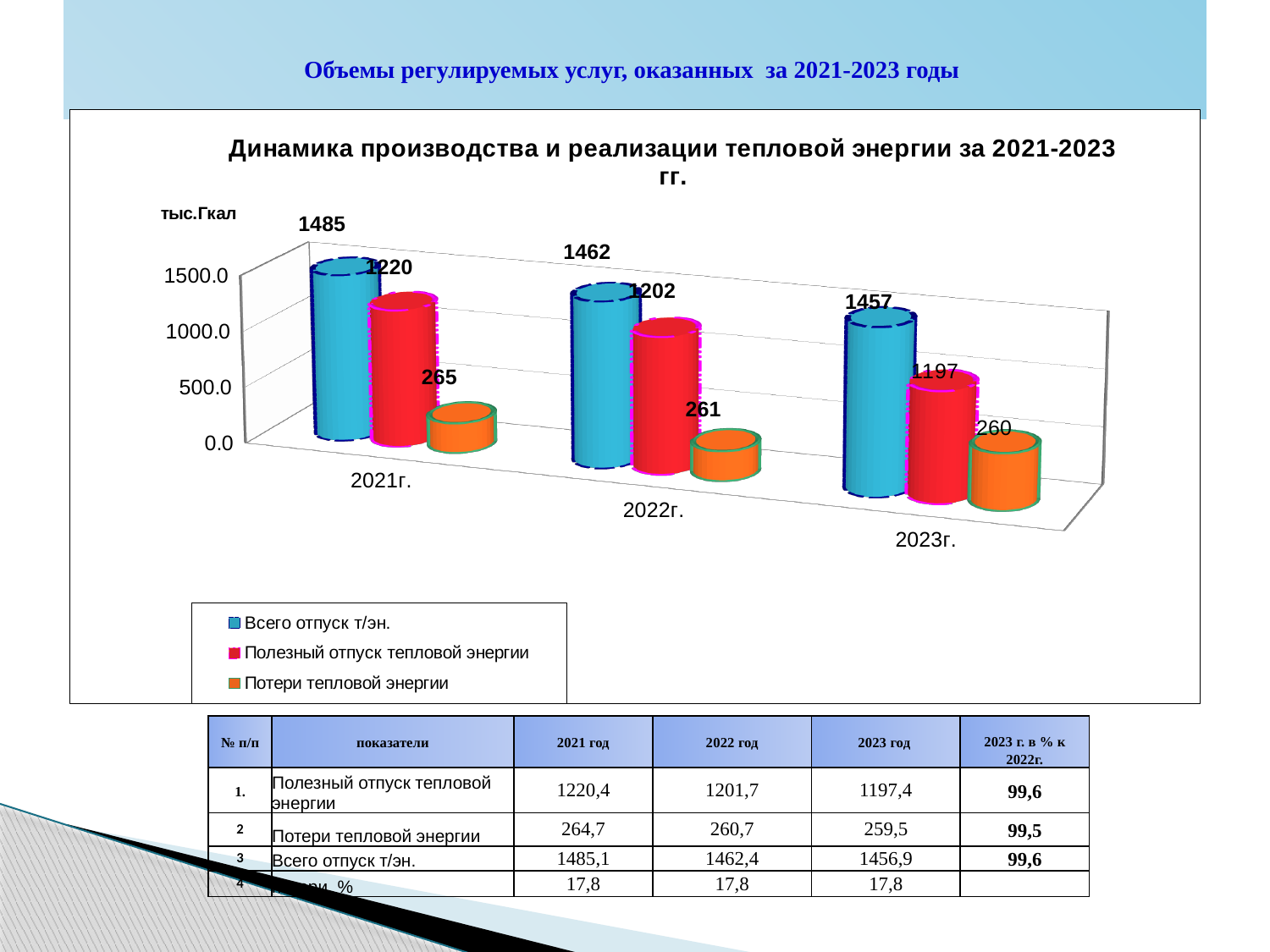
What is the value for "Всего отпуск т/эн." in 2021г.? 1485 How many years are shown on the x axis of the chart? 3 How many series does the chart legend list? 3 Does "Всего отпуск т/эн." rise or fall from 2021г. to 2023г.? fall Is the value for "Потери тепловой энергии" in 2022г. greater or less than 500.0? less In which year is "Потери тепловой энергии" lowest? 2023г. What is the value for "Потери тепловой энергии" in 2023г.? 260 What is the difference between "Всего отпуск т/эн." in 2021г. and in 2023г.? 28 In which year is "Всего отпуск т/эн." highest? 2021г. What kind of chart is shown on the slide? bar chart What is the value for "Полезный отпуск тепловой энергии" in 2022г.? 1202 Which is larger: "Полезный отпуск тепловой энергии" in 2021г. or in 2023г.? 2021г.